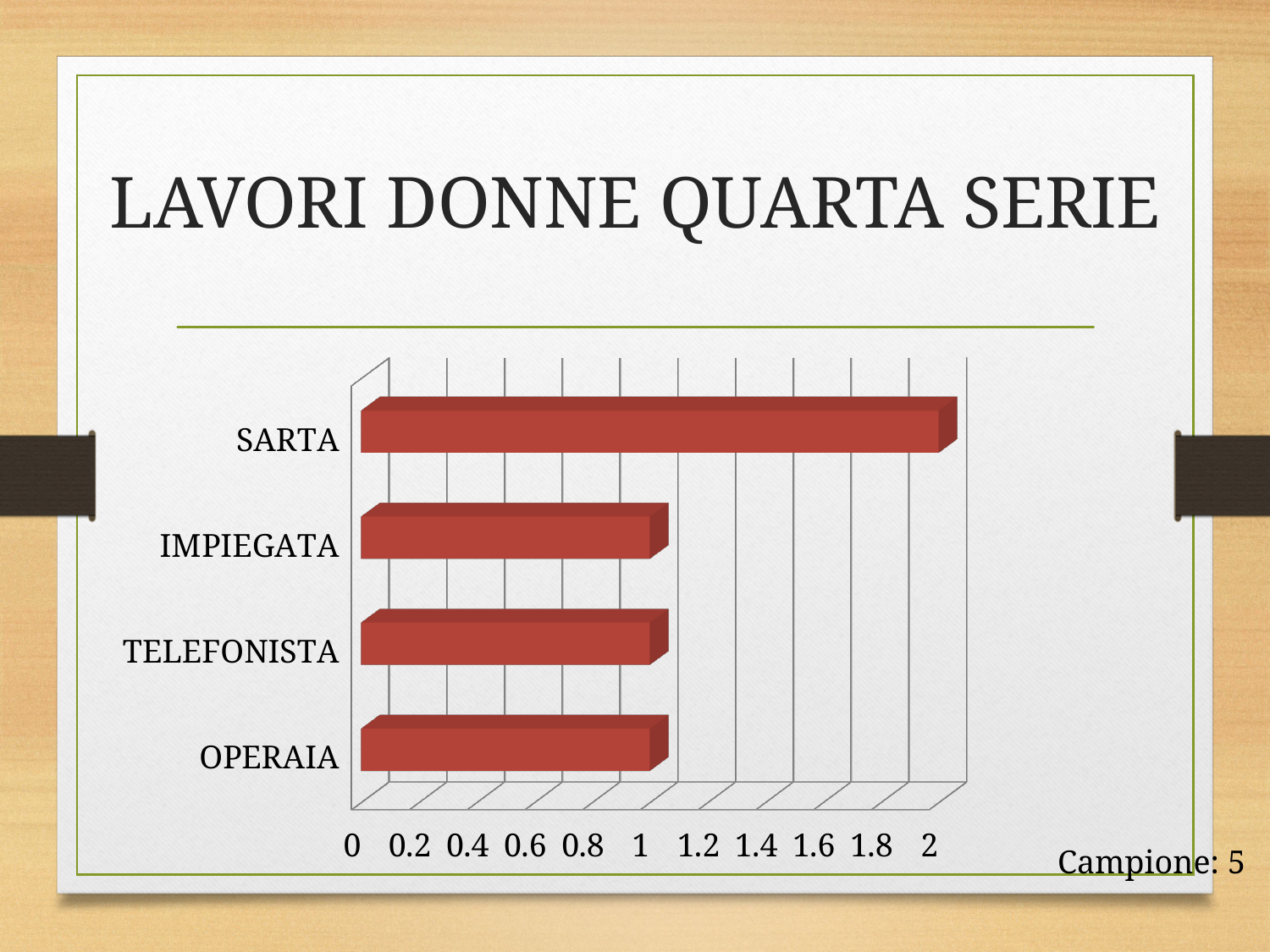
What sample size (Campione) is noted on the slide? 5 How many categories are shown in the chart? 4 What is the title of the slide containing the chart? LAVORI DONNE QUARTA SERIE Is the value for IMPIEGATA greater or less than 1.4? less Which category has the highest value in the chart? SARTA Is the value for SARTA greater or less than 1.8? greater What is the difference between the value for SARTA and the value for OPERAIA? 1 What is the value for OPERAIA? 1 What kind of chart is shown on the slide? bar chart Is the value for TELEFONISTA greater or less than 0.8? greater Which is larger, the value for SARTA or the value for IMPIEGATA? SARTA What is the value for SARTA? 2